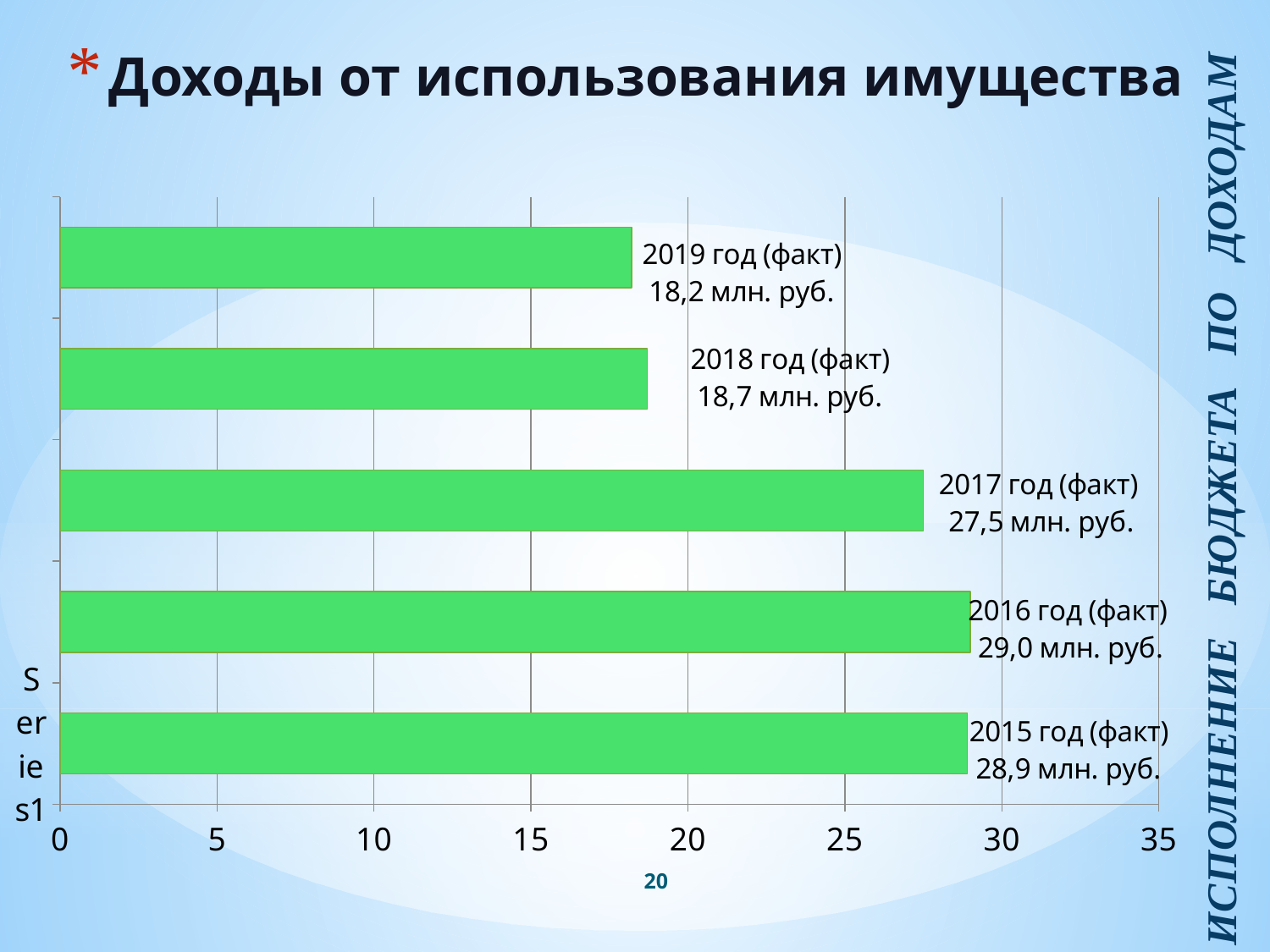
Which year has the highest value? 2016 год (факт) How many bars are shown in the chart? 5 What kind of chart is shown on the slide? bar chart Is the value for 2017 год (факт) greater or less than 25? greater What is the difference between the values for 2017 and 2019? 9,3 млн. руб. What is the value for 2017 год (факт)? 27,5 млн. руб. Which year has the lowest value? 2019 год (факт) What is the title of the chart? Доходы от использования имущества Do the values rise or fall from 2016 to 2019? fall What is the value for 2019 год (факт)? 18,2 млн. руб. What is the value for 2015 год (факт)? 28,9 млн. руб. Which is larger, the value for 2017 or the value for 2018? 2017